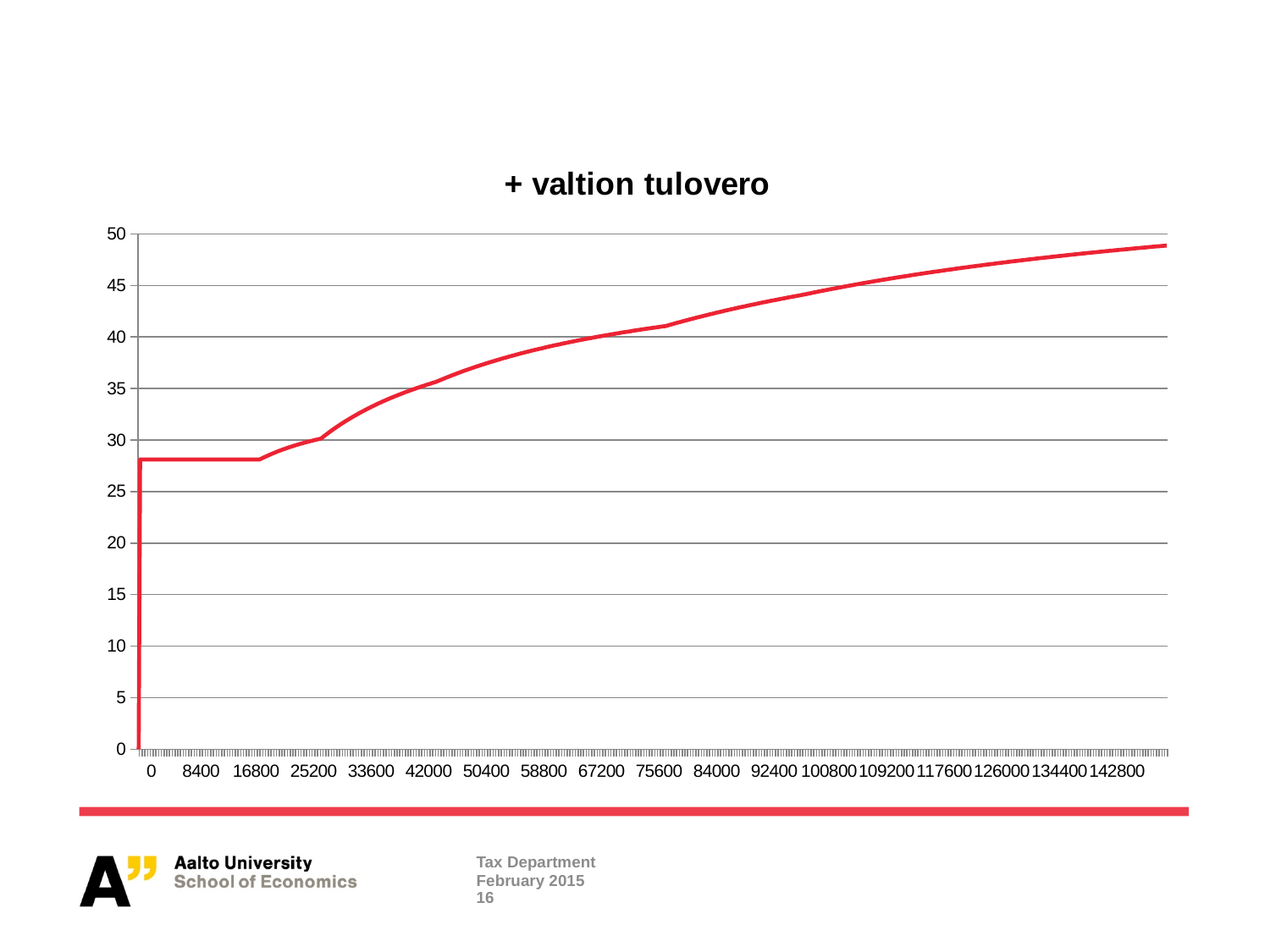
Is the value at 142800 greater or less than 45? greater Is the value at 84000 greater or less than 40? greater Is the value at 50400 greater or less than 35? greater What is the title of the chart? + valtion tulovero What is the highest value shown on the vertical axis? 50 Do the values generally rise or fall as you move right along the x axis? rise Which is larger, the value at 8400 or the value at 42000? 42000 What kind of chart is shown on the slide? line chart